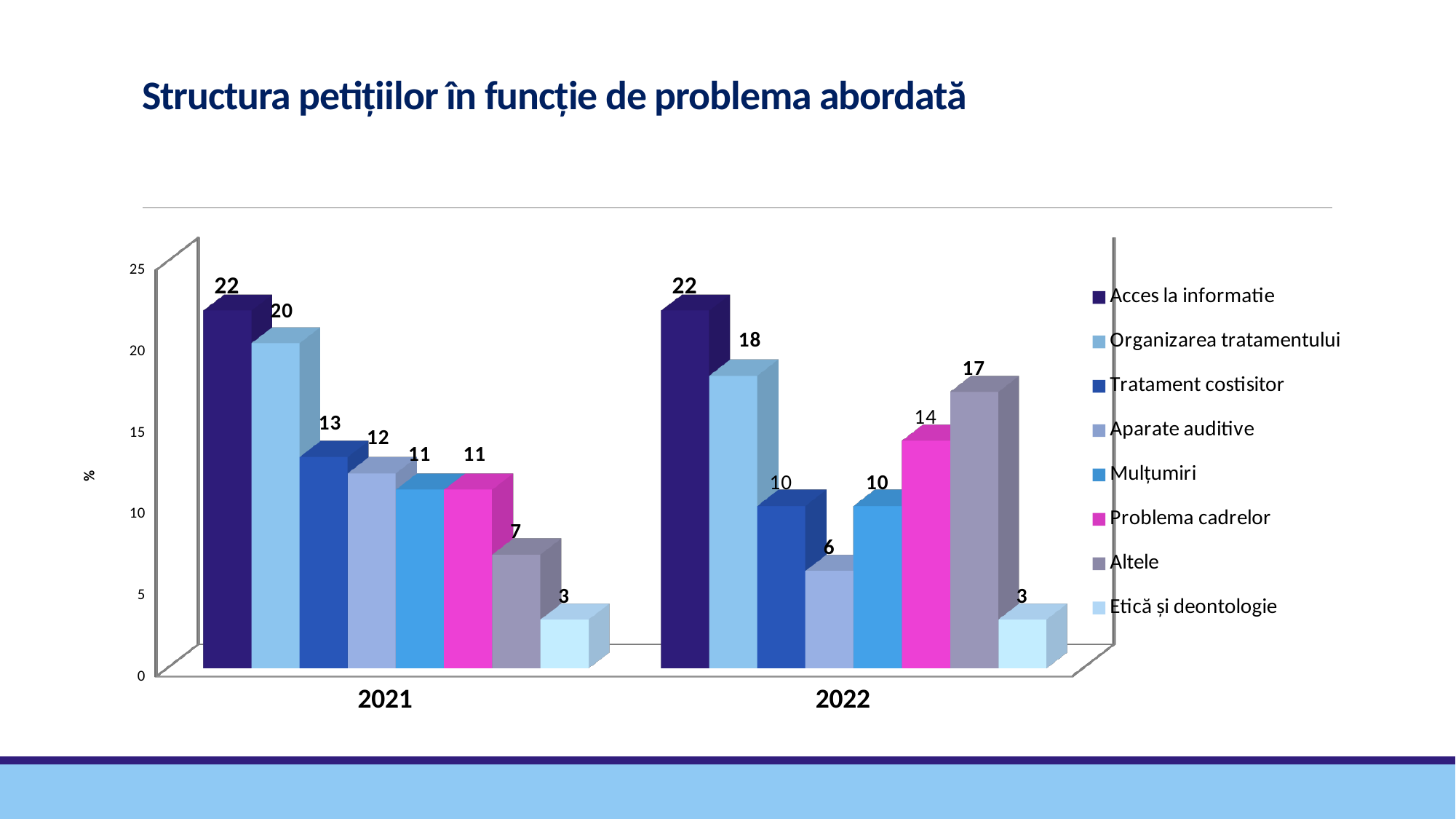
What is the difference between Organizarea tratamentului in 2021 and in 2022? 2 What is the value for Acces la informatie in 2021? 22 How many categories are shown on the x axis? 2 How many series does the legend list? 8 Which series has the highest value in 2022? Acces la informatie What kind of chart is shown on the slide? Bar chart What is the title of the slide? Structura petițiilor în funcție de problema abordată Which is larger: Problema cadrelor in 2021 or Problema cadrelor in 2022? Problema cadrelor in 2022 What is the value for Aparate auditive in 2022? 6 What is the value for Organizarea tratamentului in 2022? 18 What is the value for Altele in 2022? 17 Which series has the lowest value in 2021? Etică și deontologie